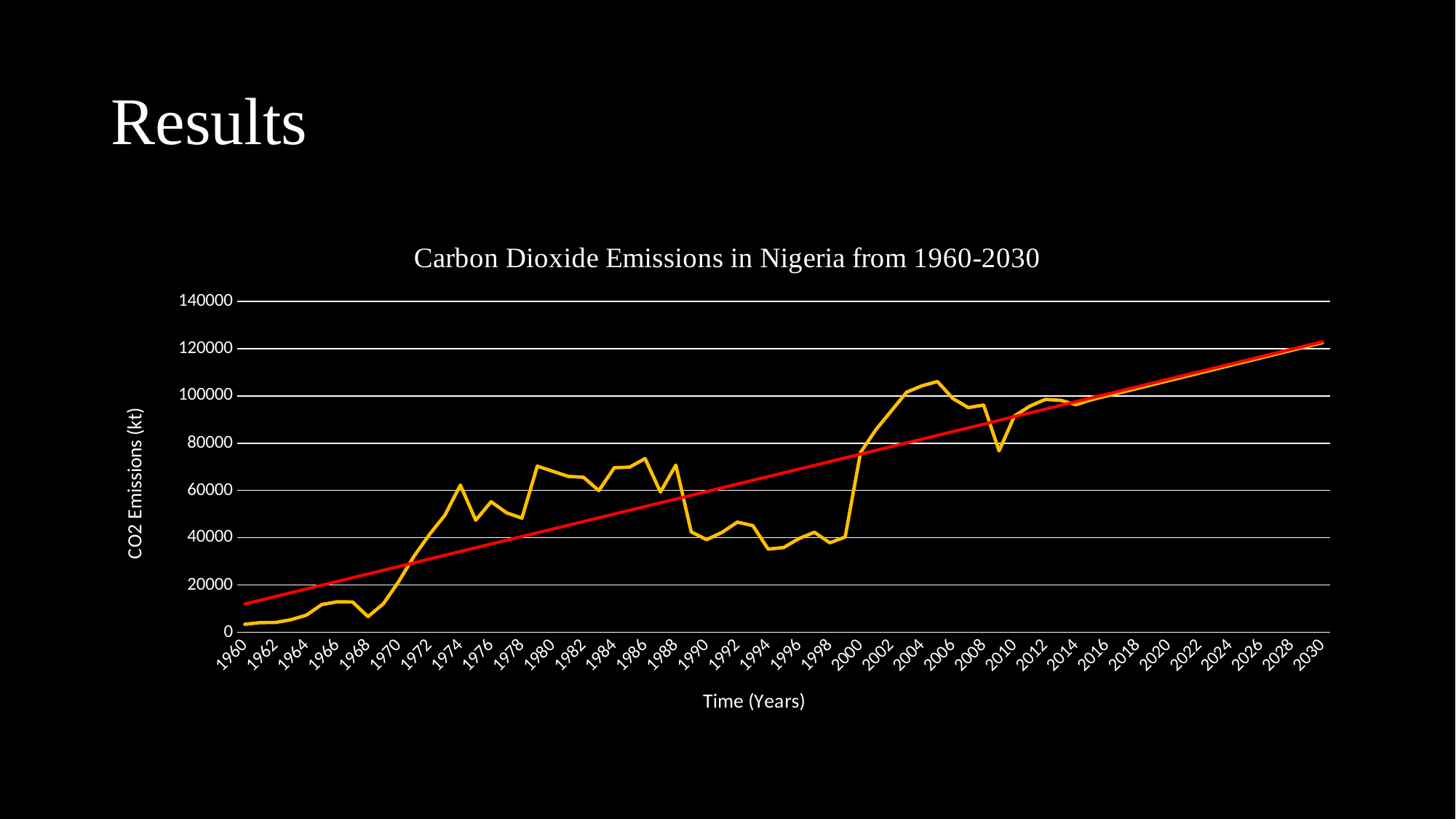
What is the title of the chart? Carbon Dioxide Emissions in Nigeria from 1960-2030 Is the CO2 emissions value for 1960 greater or less than 20000? less Is the CO2 emissions value for 1980 greater or less than 60000? greater What is the label of the vertical axis? CO2 Emissions (kt) Is the CO2 emissions value for 2009 greater or less than 100000? less Overall, do CO2 emissions rise or fall from 1960 to 2014 along the x axis? Rise What kind of chart is shown on the slide? Line chart Which year has the lowest CO2 emissions value on the yellow line? 1960 Which is larger, the CO2 emissions value for 1974 or for 1994? 1974